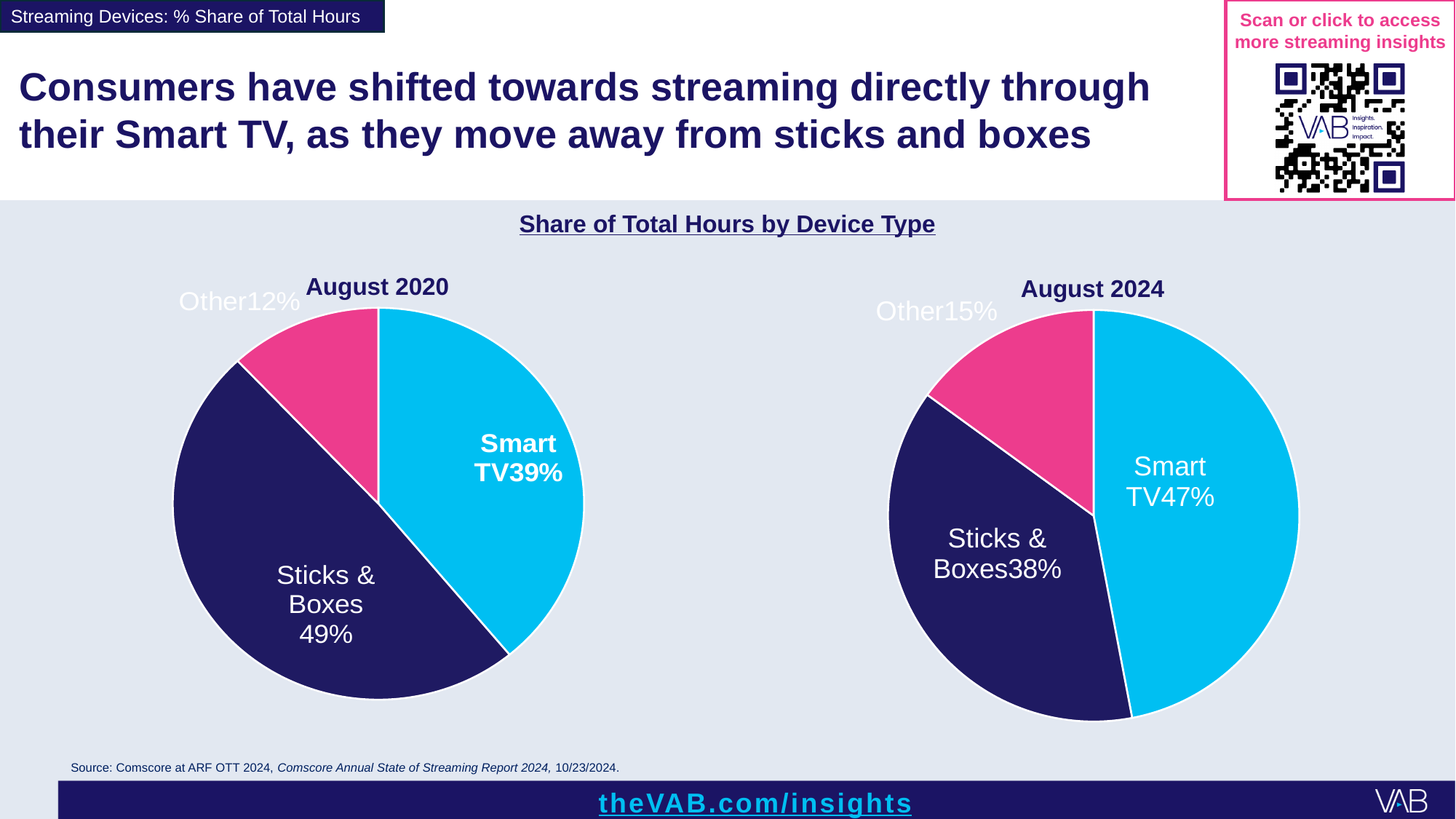
What type of chart is used to show the share of total hours by device type? Pie chart In the August 2024 pie chart, which device type has the largest share? Smart TV Which is larger in the August 2024 pie chart: the Smart TV share or the Sticks & Boxes share? Smart TV In the August 2020 pie chart, what share of total hours does Smart TV have? 39% In the August 2024 pie chart, what is the share for Other? 15% In the August 2024 pie chart, which device type has the smallest share? Other In the August 2024 pie chart, what share of total hours does Sticks & Boxes have? 38% How many slices does the August 2020 pie chart have? 3 In the August 2020 pie chart, what is the share for Other? 12% In the August 2020 pie chart, which device type has the largest share? Sticks & Boxes What is the difference between the Smart TV share in August 2024 and in August 2020? 8 percentage points In the August 2020 pie chart, what is the difference between the Sticks & Boxes share and the Smart TV share? 10 percentage points